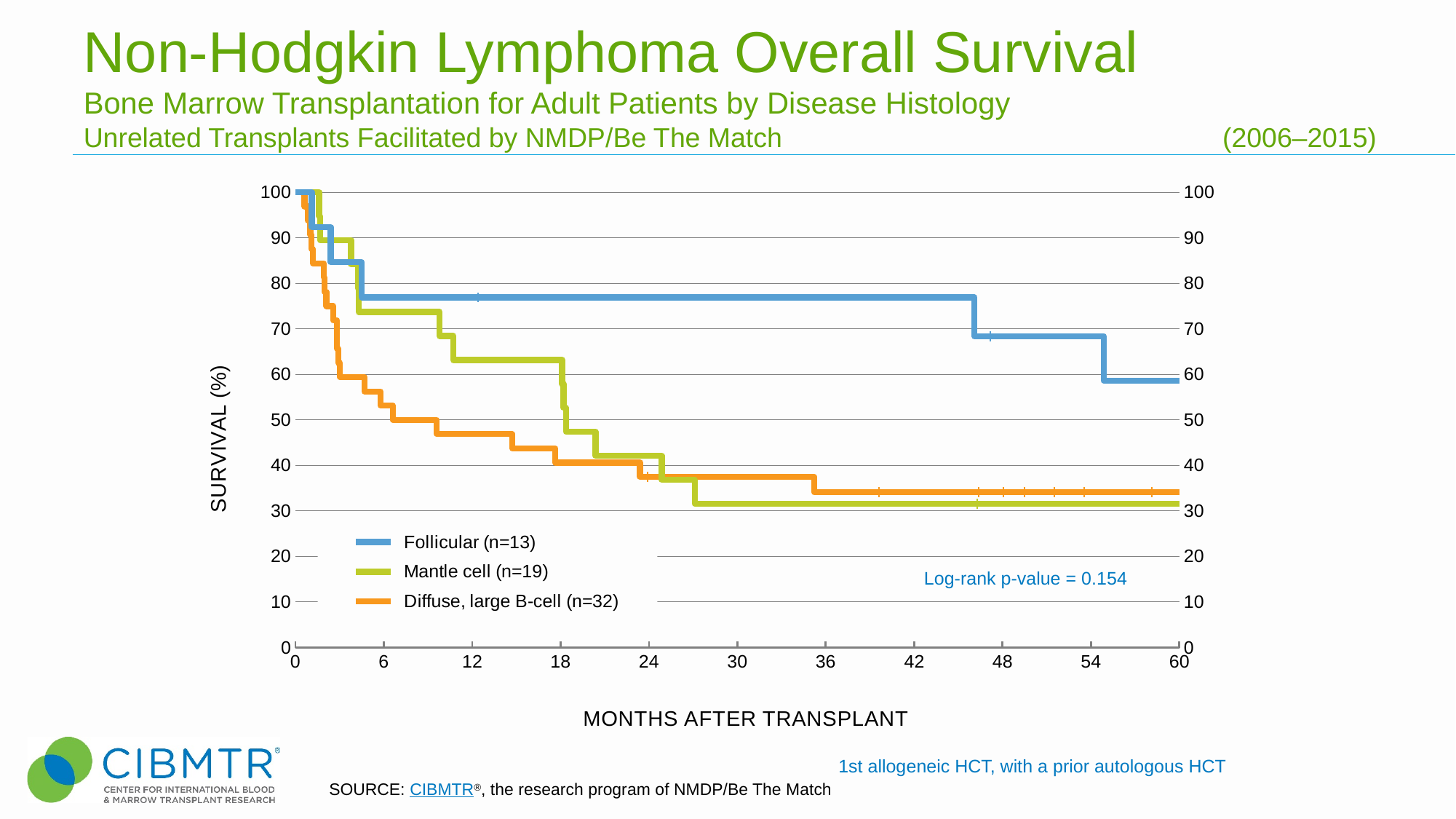
Is the survival for Follicular at 60 months greater or less than 50? greater Which series has the lowest survival at 30 months after transplant? Mantle cell (n=19) How many patients are in the Diffuse, large B-cell group according to the legend? 32 Do the survival curves rise or fall as months after transplant increase? fall Is the survival for Follicular at 24 months greater or less than 70? greater Is the survival for Diffuse, large B-cell at 12 months greater or less than 50? less Which series has the highest survival at 60 months after transplant? Follicular (n=13) What kind of chart is shown on the slide? Line chart (survival curve) How many series does the legend list? 3 What is the log-rank p-value shown on the chart? 0.154 At 12 months after transplant, which series has higher survival: Mantle cell or Diffuse, large B-cell? Mantle cell